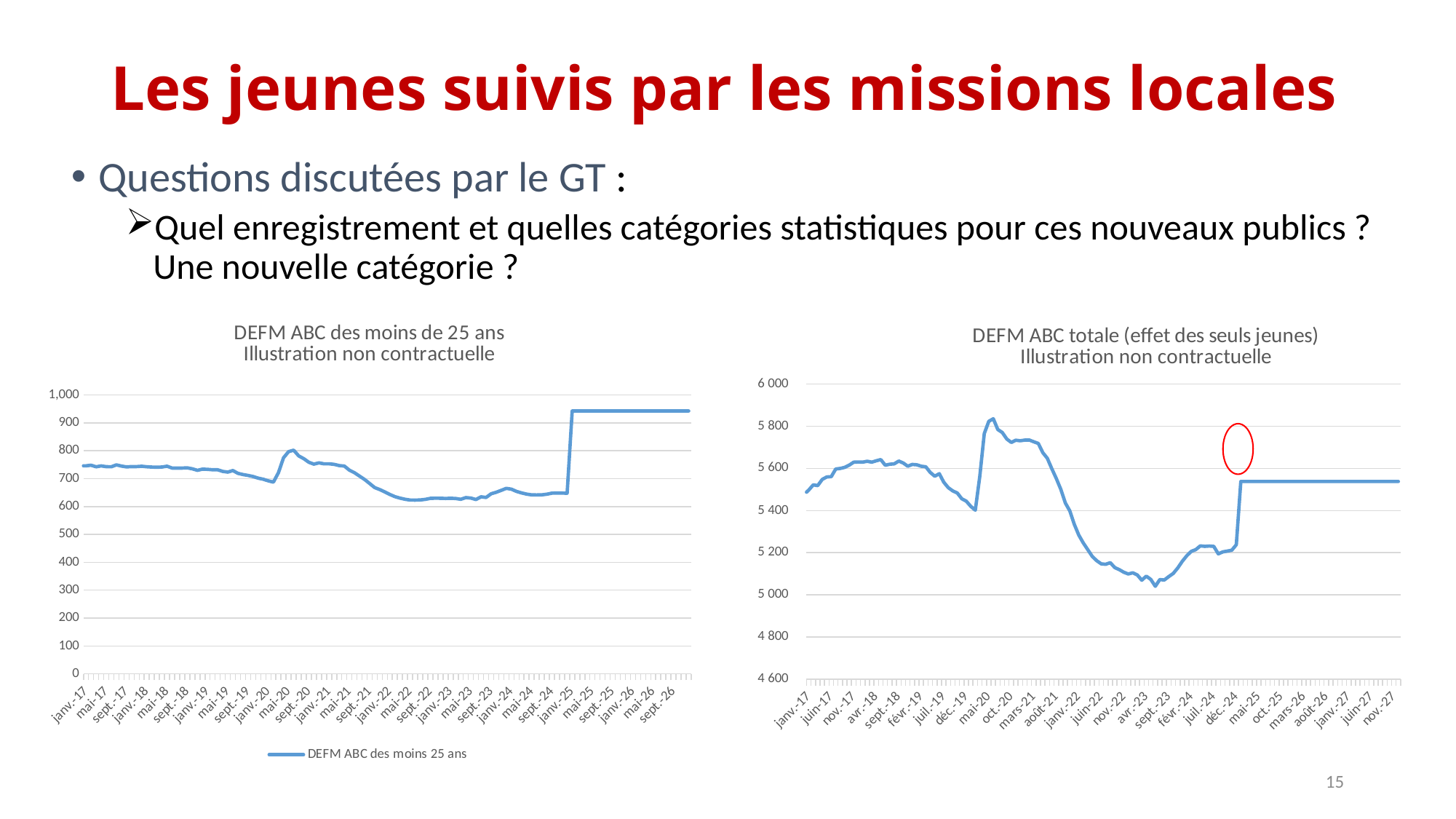
In the right chart 'DEFM ABC totale (effet des seuls jeunes)', which is higher: the peak around mai-20 or the flat level after mai-25? The peak around mai-20 In the right chart 'DEFM ABC totale (effet des seuls jeunes)', does the line rise or fall between mai-20 and sept.-23? Falls In the left chart 'DEFM ABC des moins de 25 ans', is the value for mai-20 greater or less than 700? greater In the left chart 'DEFM ABC des moins de 25 ans', is the value for sept.-26 greater or less than 900? greater In the right chart 'DEFM ABC totale (effet des seuls jeunes)', is the value for nov.-27 greater or less than 5 400? greater In the left chart 'DEFM ABC des moins de 25 ans', does the line rise, fall or stay flat between janv.-25 and sept.-26? Stays flat What kind of chart is the left chart, 'DEFM ABC des moins de 25 ans'? Line chart What kind of chart is the right chart, 'DEFM ABC totale (effet des seuls jeunes)'? Line chart In the left chart 'DEFM ABC des moins de 25 ans', what is the legend entry? DEFM ABC des moins 25 ans In the left chart 'DEFM ABC des moins de 25 ans', how many series does the legend list? 1